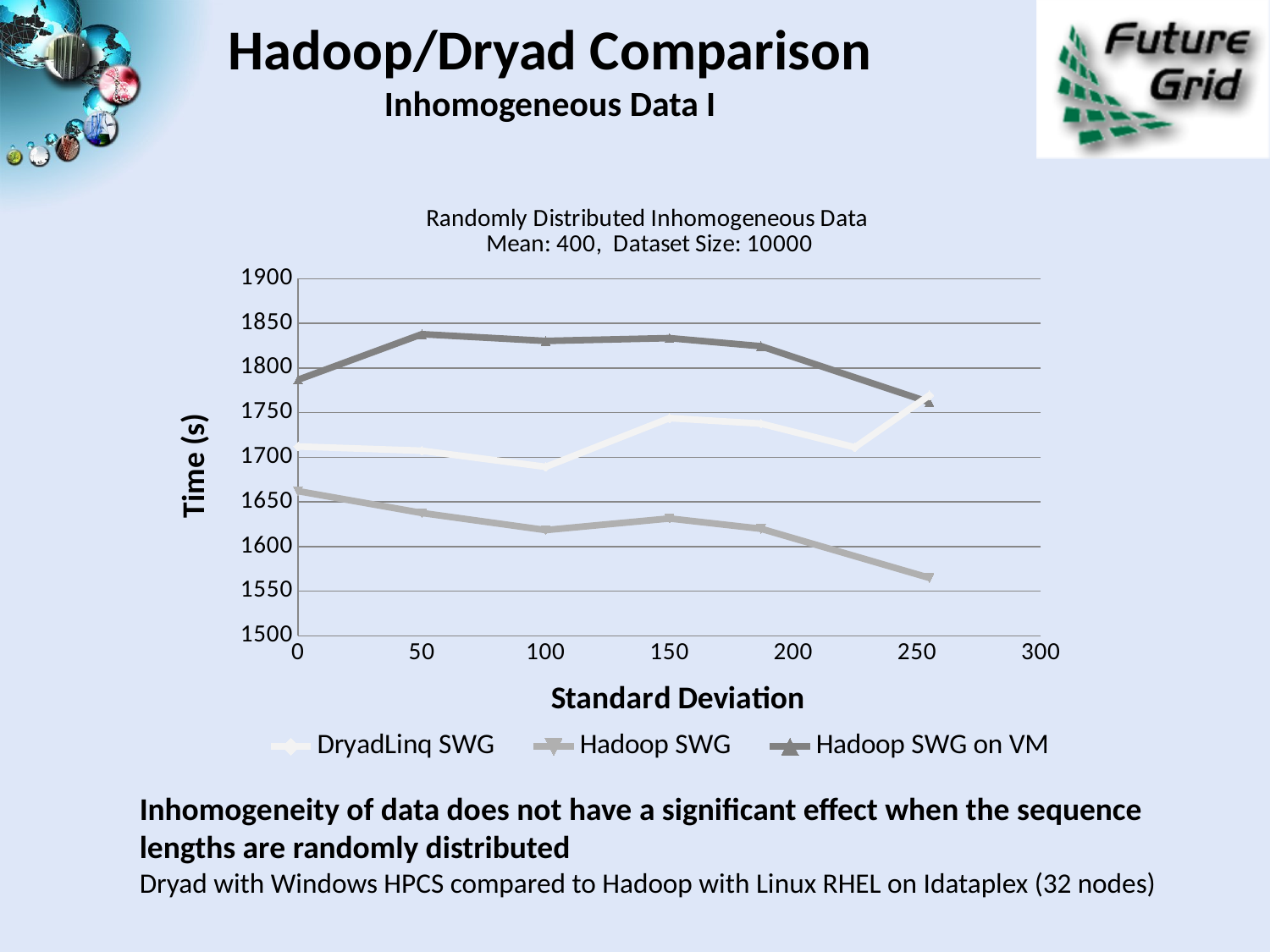
Does the Hadoop SWG series generally rise or fall as standard deviation increases? fall Is the value for Hadoop SWG at standard deviation 250 greater or less than 1600? less Which series has the lowest times across the chart? Hadoop SWG At standard deviation 50, which series has the higher time: Hadoop SWG on VM or Hadoop SWG? Hadoop SWG on VM How many series does the chart legend list? 3 What kind of chart is shown on the slide? line chart Is the value for Hadoop SWG on VM at standard deviation 50 greater or less than 1800? greater Is the value for DryadLinq SWG at standard deviation 150 greater or less than 1700? greater What is the label of the y axis of the chart? Time (s) What is the label of the x axis of the chart? Standard Deviation At standard deviation 0, which series has the higher time: DryadLinq SWG or Hadoop SWG? DryadLinq SWG